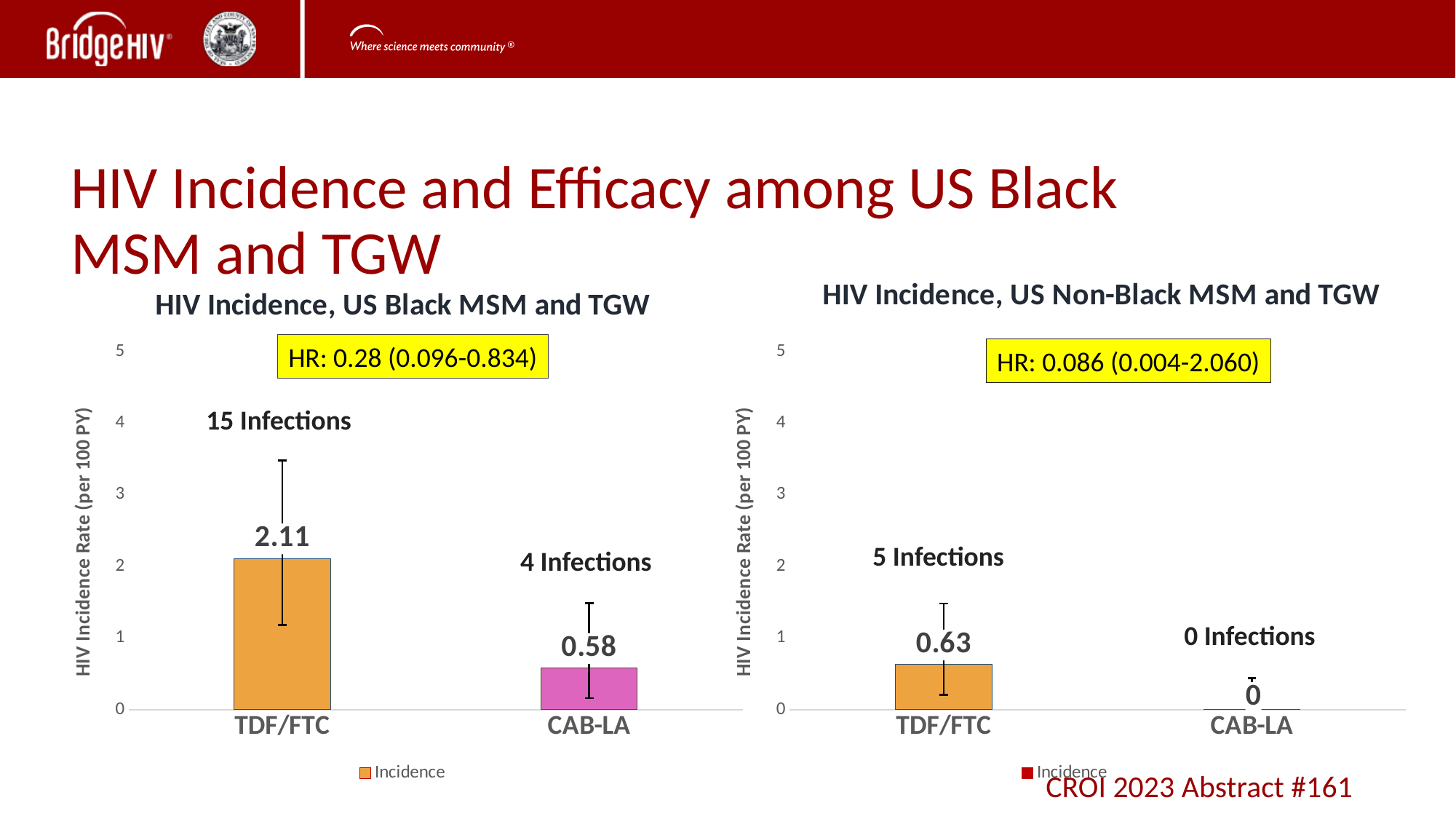
In the 'HIV Incidence, US Non-Black MSM and TGW' chart, what is the HIV incidence rate for TDF/FTC? 0.63 How many infections are noted for the CAB-LA arm in the 'HIV Incidence, US Non-Black MSM and TGW' chart? 0 Infections In the 'HIV Incidence, US Non-Black MSM and TGW' chart, which arm has the higher incidence rate? TDF/FTC What hazard ratio is shown in the yellow box on the 'HIV Incidence, US Non-Black MSM and TGW' chart? HR: 0.086 (0.004-2.060) In the 'HIV Incidence, US Black MSM and TGW' chart, what is the HIV incidence rate for TDF/FTC? 2.11 In the 'HIV Incidence, US Non-Black MSM and TGW' chart, what is the HIV incidence rate for CAB-LA? 0 In the 'HIV Incidence, US Black MSM and TGW' chart, what is the difference between the TDF/FTC and CAB-LA incidence rates? 1.53 Is the TDF/FTC incidence rate in the 'HIV Incidence, US Black MSM and TGW' chart greater or less than 2? greater How many infections are noted for the TDF/FTC arm in the 'HIV Incidence, US Black MSM and TGW' chart? 15 Infections In the 'HIV Incidence, US Black MSM and TGW' chart, which arm has the lower incidence rate? CAB-LA What type of chart is the 'HIV Incidence, US Black MSM and TGW' chart? Bar chart In the 'HIV Incidence, US Black MSM and TGW' chart, what is the HIV incidence rate for CAB-LA? 0.58